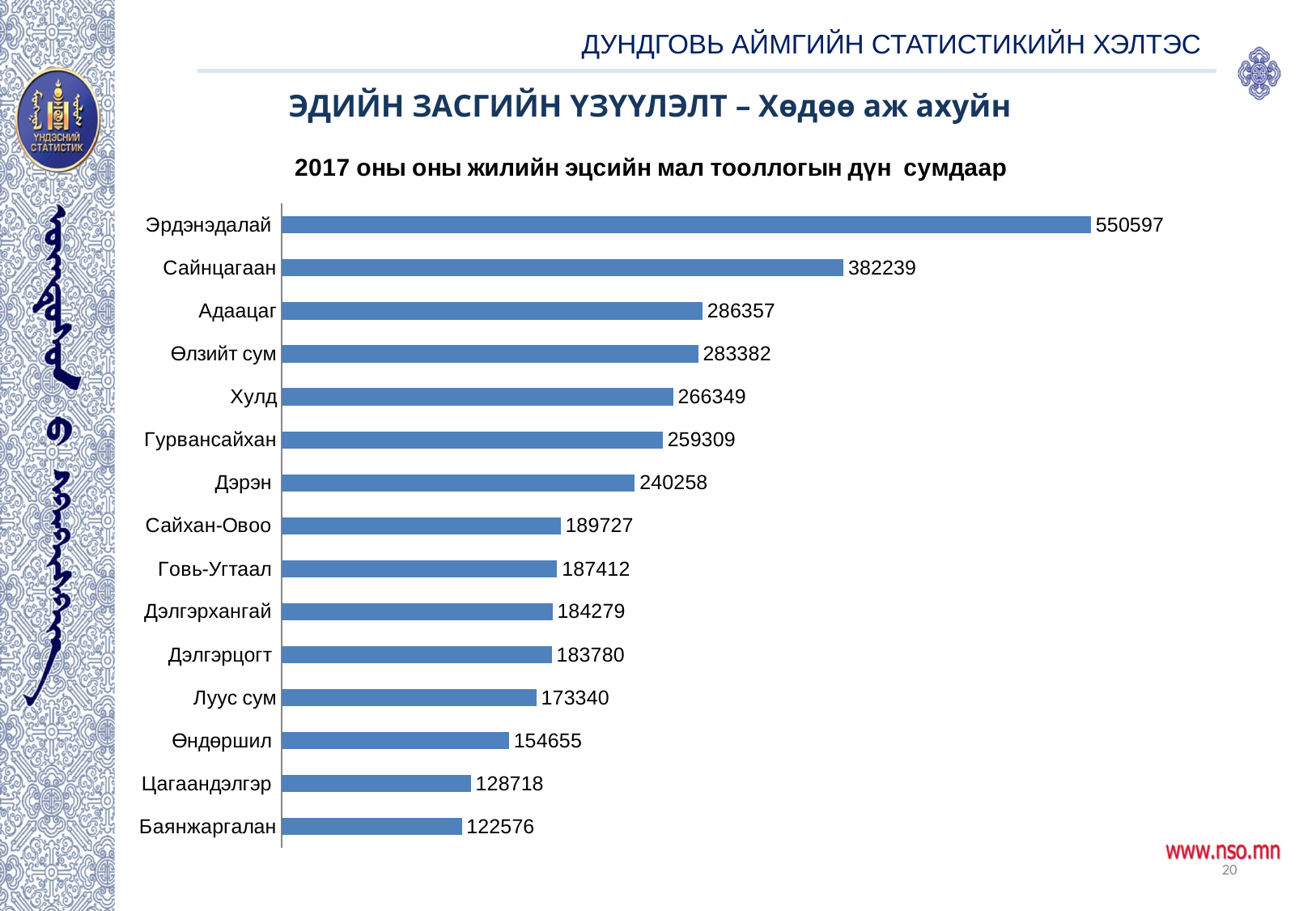
What is the title of the chart? 2017 оны оны жилийн эцсийн мал тооллогын дүн сумдаар How many categories are shown in the chart? 15 Which category has the lowest value? Баянжаргалан What is the difference between the values for Цагаандэлгэр and Баянжаргалан? 6142 Which is larger, the value for Адаацаг or the value for Дэрэн? Адаацаг What is the difference between the values for Эрдэнэдалай and Сайнцагаан? 168358 What is the value for Цагаандэлгэр? 128718 What is the value for Дэлгэрцогт? 183780 What kind of chart is shown on the slide? Bar chart What is the value for Эрдэнэдалай? 550597 What is the value for Хулд? 266349 Which category has the highest value? Эрдэнэдалай